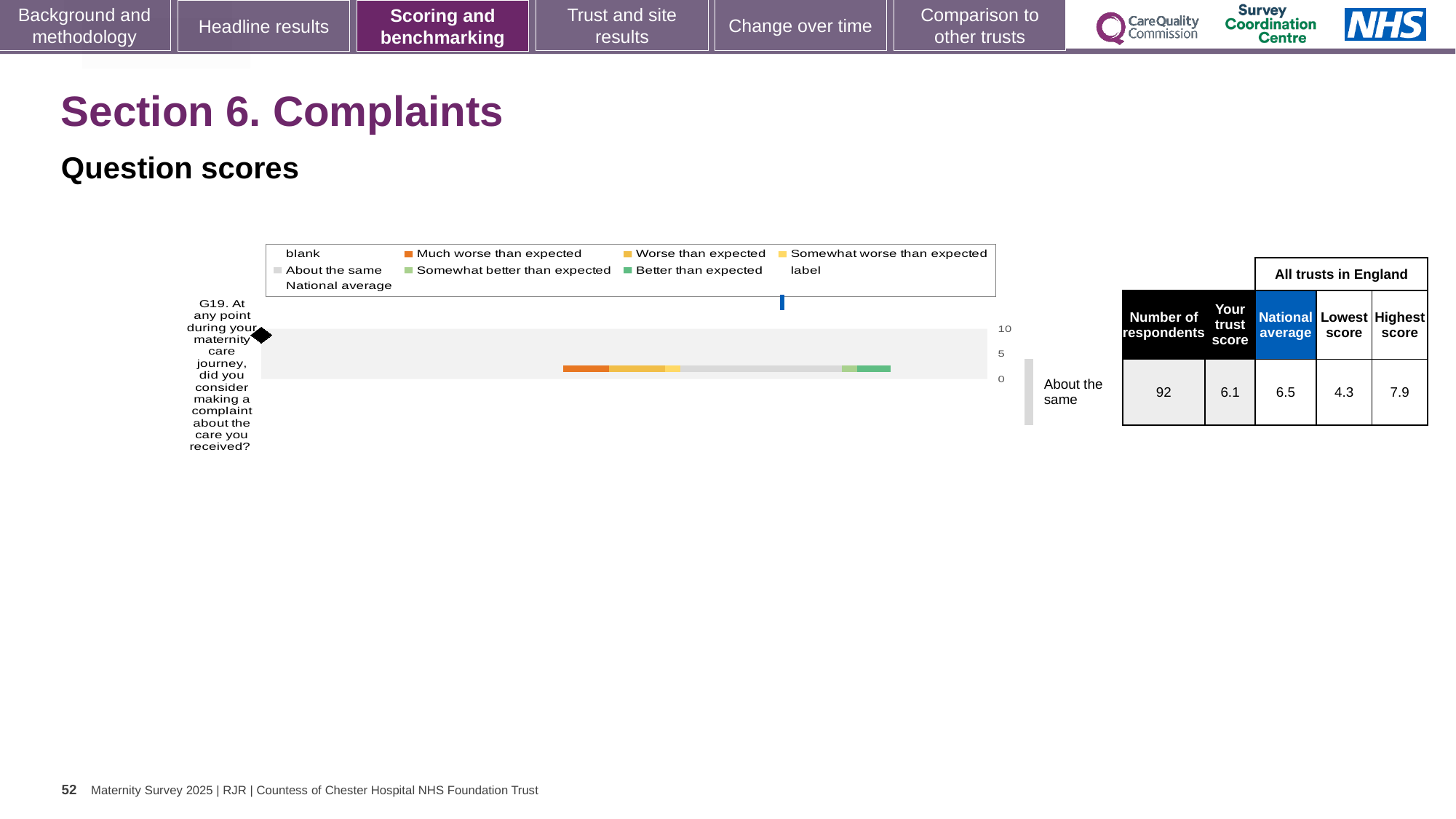
By how much does the national average exceed the trust score for question G19? 0.4 What is the trust's score for question G19? 6.1 What is the difference between the highest and lowest scores for question G19? 3.6 What colour does the legend use for 'Much worse than expected'? Orange What is the national average score for question G19? 6.5 How is the trust's result for question G19 categorised relative to expectations? About the same What kind of chart is used to show the G19 question score? bar chart What is the number of respondents for question G19? 92 How many survey questions are plotted on the chart? 1 What is the lowest score among all trusts in England for question G19? 4.3 Which is larger for question G19, the trust score or the national average? National average What is the highest score among all trusts in England for question G19? 7.9